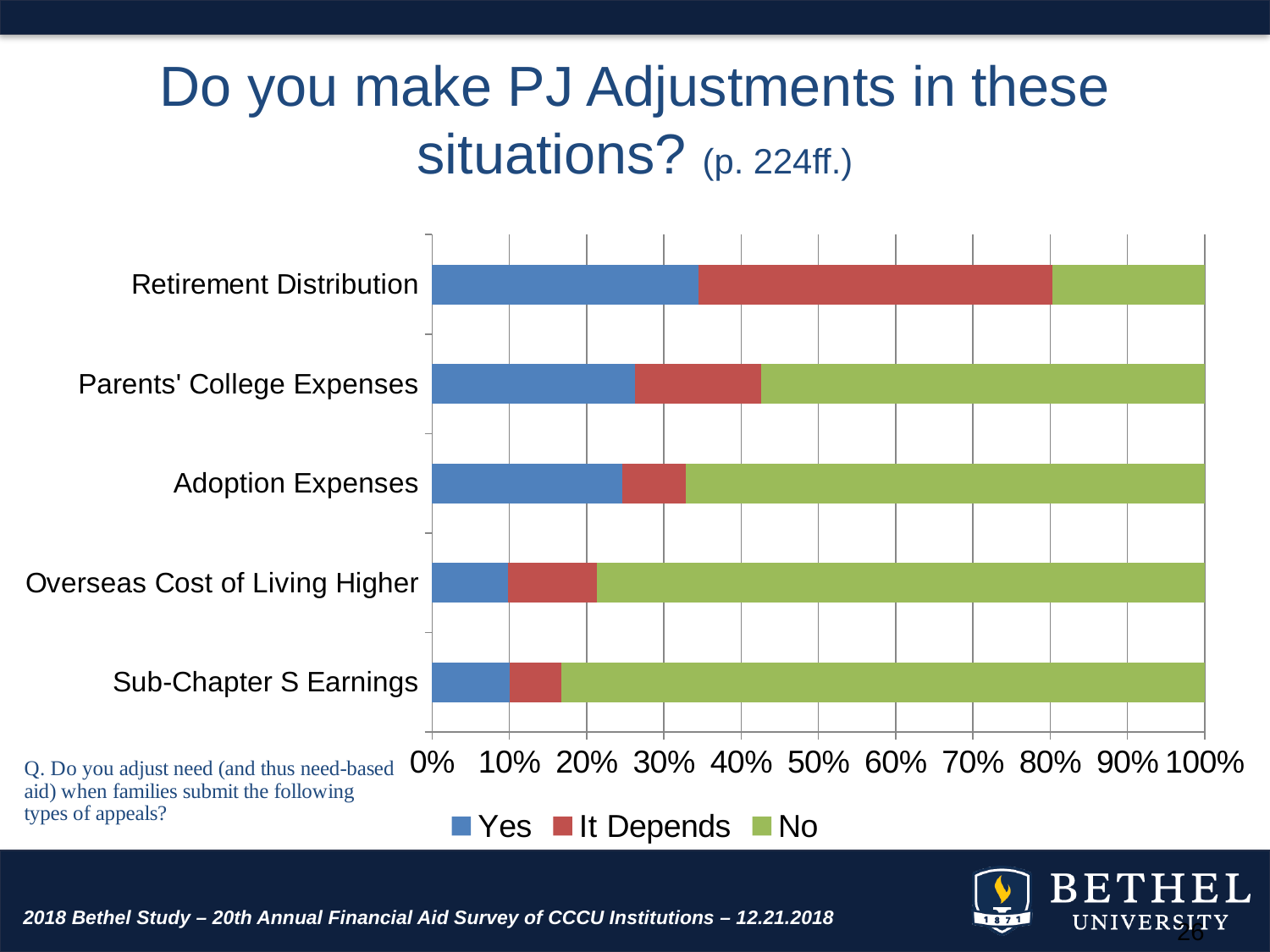
Which colour represents the "No" responses in the chart? Green What are the three response options shown in the legend? Yes, It Depends, No Which has a larger "It Depends" share: Parents' College Expenses or Adoption Expenses? Parents' College Expenses Which situation has the largest "It Depends" share? Retirement Distribution How many series does the chart legend list? 3 Which situation has the smallest "No" share? Retirement Distribution Is the "Yes" share for Overseas Cost of Living Higher greater or less than 20%? less Which situation has the largest "Yes" share? Retirement Distribution Is the "Yes" share for Retirement Distribution greater or less than 30%? greater How many situations (categories) are listed on the chart? 5 What kind of chart is shown on the slide? Stacked bar chart Is the "No" share for Sub-Chapter S Earnings greater or less than 70%? greater